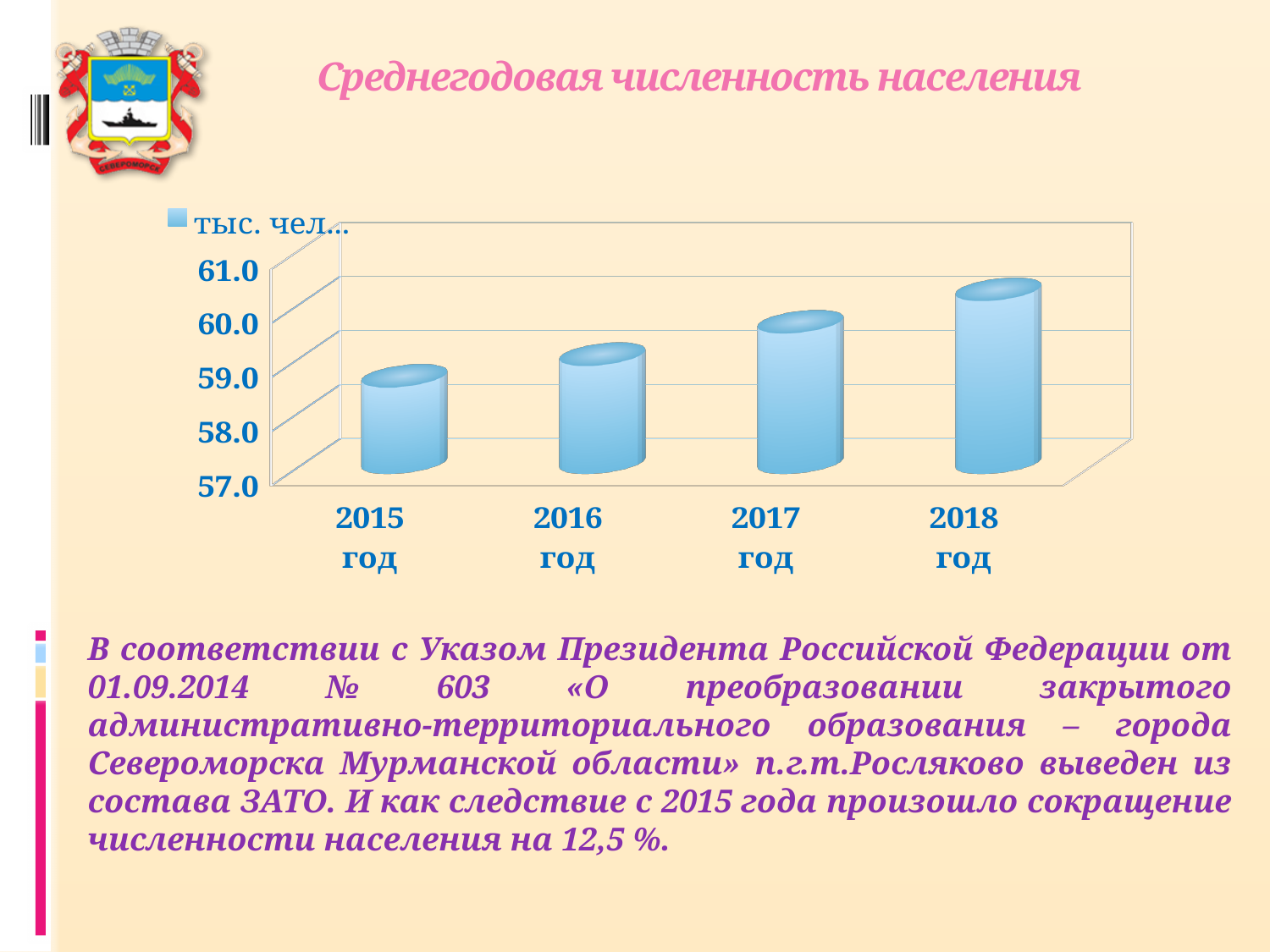
Is the value for 2017 год greater or less than 61.0? less Is the value for 2015 год greater or less than 58.0? greater What is the title of the chart? Среднегодовая численность населения Do the values rise or fall from 2015 to 2018 along the x axis? rise How many years (categories) are shown on the x axis of the chart? 4 How many series does the chart legend list? 1 Which year has the lowest bar in the chart? 2015 год Which is larger, the value for 2016 год or the value for 2017 год? 2017 год Is the value for 2018 год greater or less than 60.0? greater Which year has the highest bar in the chart? 2018 год Which is larger, the value for 2015 год or the value for 2018 год? 2018 год What kind of chart is shown on the slide? bar chart